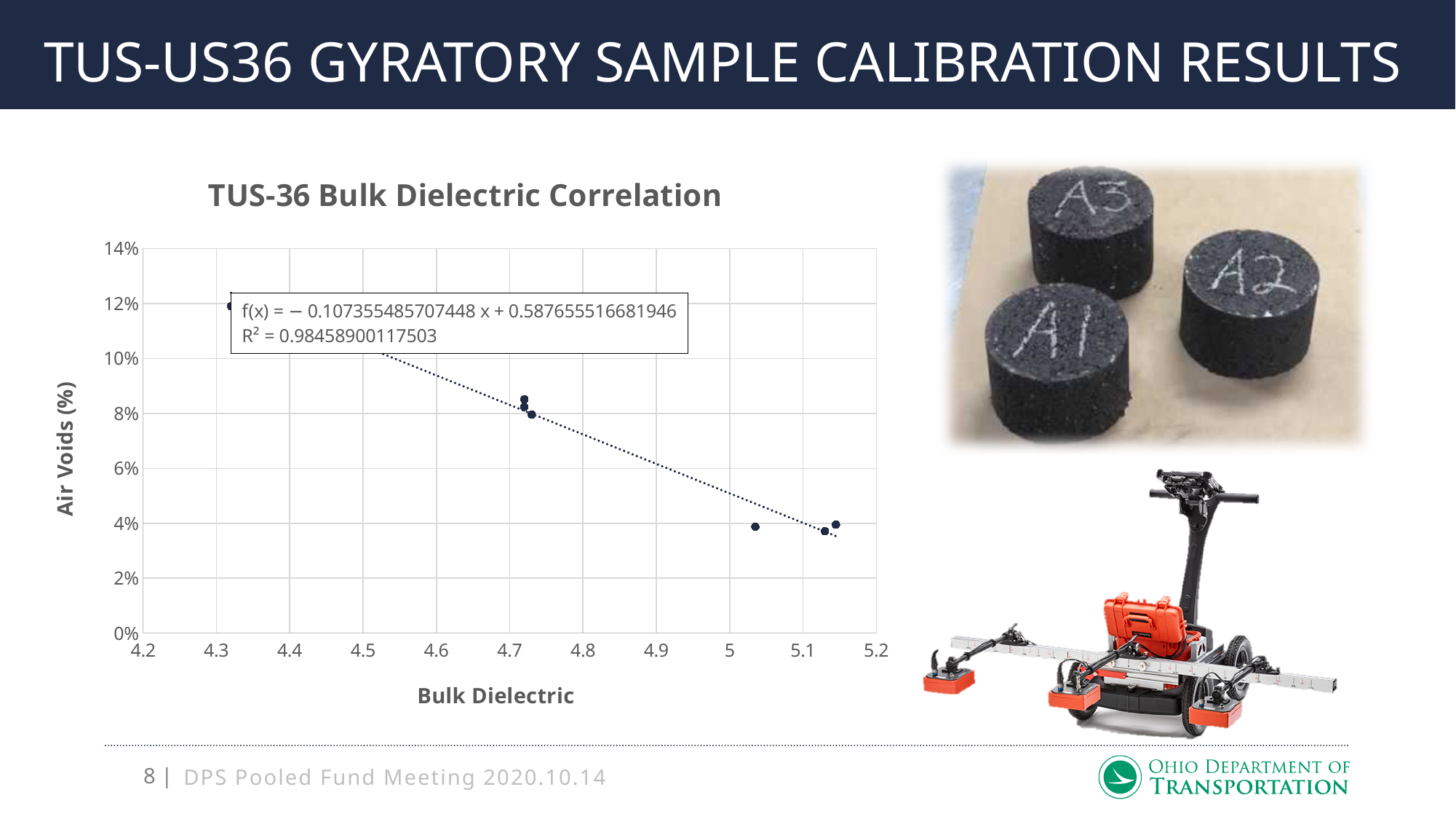
What kind of chart is shown on the slide? Scatter chart What is the label of the y axis of the chart? Air Voids (%) Are the Air Voids values for the points near a Bulk Dielectric of 4.7 greater or less than 6%? greater Are the Air Voids values for the points near a Bulk Dielectric of 5.1 greater or less than 6%? less What is the title of the chart? TUS-36 Bulk Dielectric Correlation What is the R² value shown for the trendline on the chart? 0.98458900117503 Are the Air Voids values for the points near a Bulk Dielectric of 4.7 greater or less than 10%? less As Bulk Dielectric increases along the x axis, do the Air Voids values rise or fall? Fall What is the maximum value shown on the y axis of the chart? 14% Which has the higher Air Voids value: the point at a Bulk Dielectric of about 4.3 or the point at about 5.0? The point at about 4.3